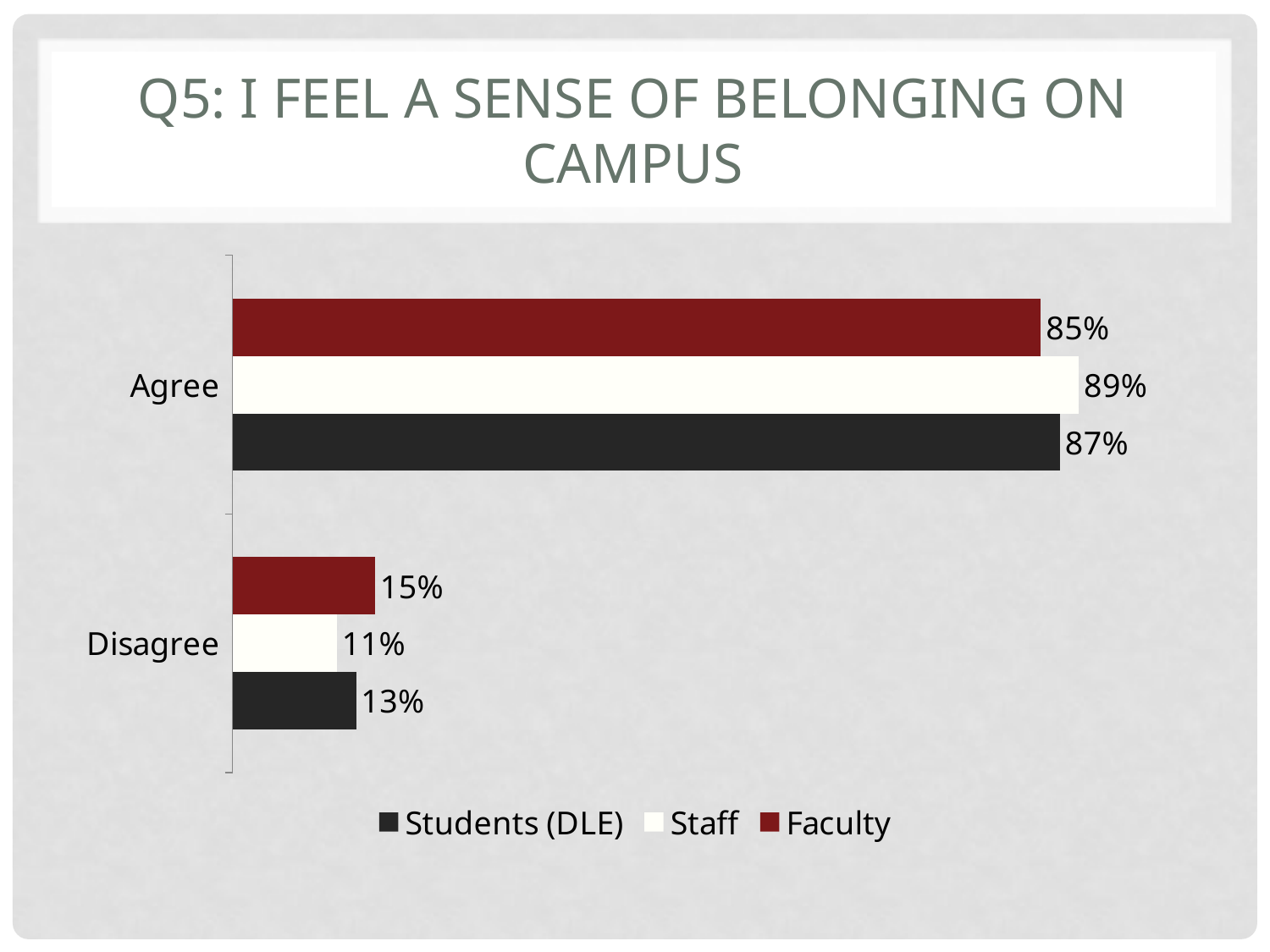
Which group has the highest Agree percentage? Staff What is the value for Students (DLE) in the Disagree category? 13% Which series is shown in dark red? Faculty What percentage of Faculty disagree with the statement? 15% What is the value for Students (DLE) in the Agree category? 87% What percentage of Staff agree that they feel a sense of belonging on campus? 89% What is the difference between the Staff and Faculty Agree percentages? 4% Which group has the lowest Disagree percentage? Staff How many series does the legend list? 3 How many response categories are shown on the chart? 2 What kind of chart is shown on the slide? Bar chart Which is larger: the Faculty Disagree value or the Students (DLE) Disagree value? Faculty Disagree